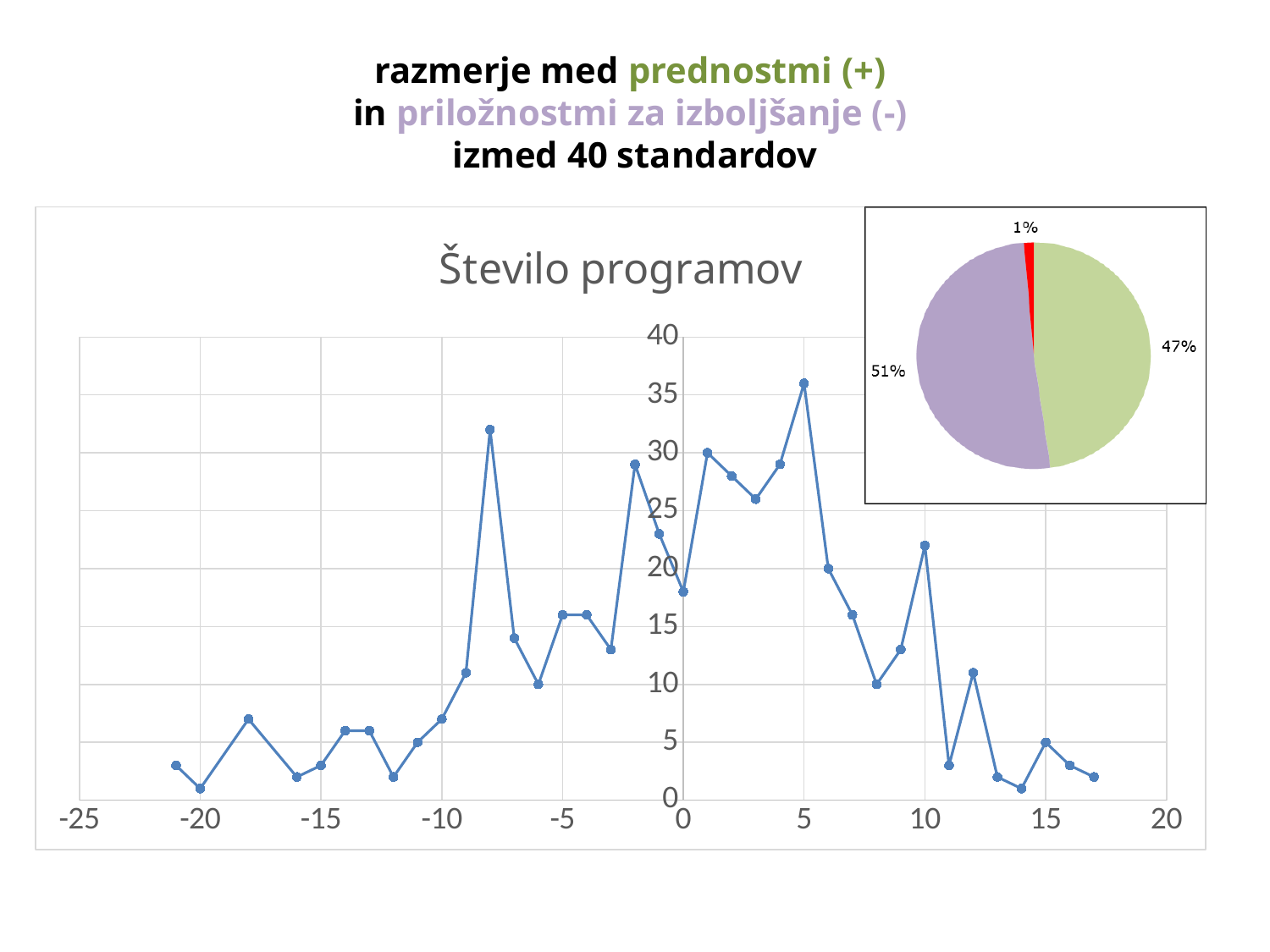
What kind of chart is the small chart in the top-right corner of the slide? pie chart In the line chart "Število programov", is the value at x = 5 greater or less than 30? greater How many slices does the pie chart have? 3 What is the title of the line chart? Število programov In the line chart "Število programov", which is larger: the value at x = 1 or the value at x = -1? x = 1 In the pie chart, what share does the largest slice have? 51% In the line chart "Število programov", at which x value does the line reach its highest point? 5 In the pie chart, what share does the green slice have? 47% In the pie chart, what share does the smallest slice have? 1% In the pie chart, what is the difference between the purple slice (51%) and the green slice (47%)? 4 percentage points In the line chart "Število programov", is the value at x = -20 greater or less than 5? less What kind of chart is the large chart titled "Število programov"? line chart